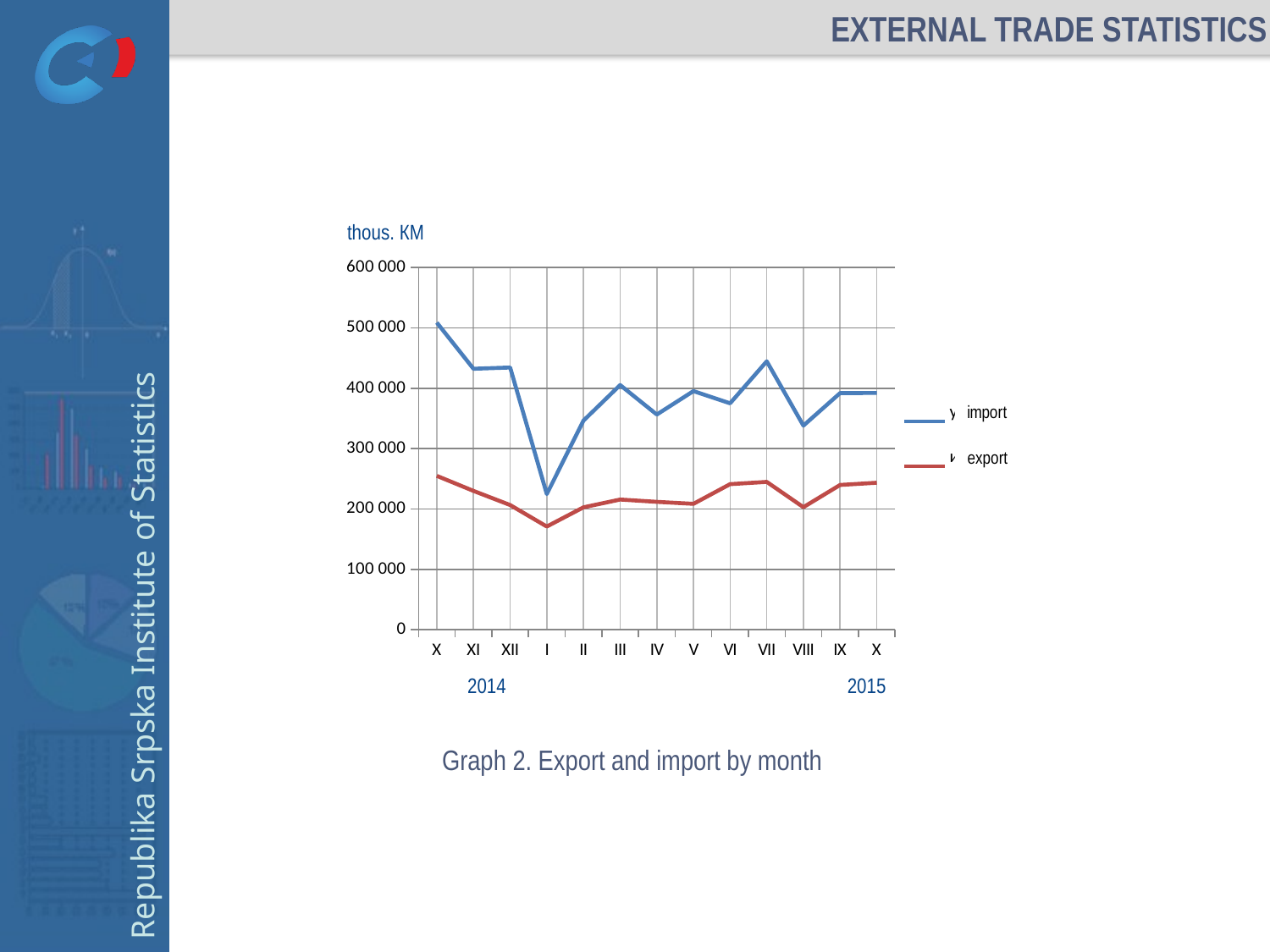
In which month is the import value highest? X 2014 How many series does the legend list? 2 Is the export value for I 2015 greater or less than 200 000? less What unit is shown above the vertical axis? thous. KM In which month is the import value lowest? I 2015 Is the import value for I 2015 greater or less than 300 000? less Is the import value for VII 2015 greater or less than 400 000? greater In which month is the export value lowest? I 2015 Does the import line rise or fall from X 2014 to I 2015? fall What kind of chart is shown on the slide? line chart Which is larger in VII 2015, import or export? import How many monthly points are plotted for each series? 13